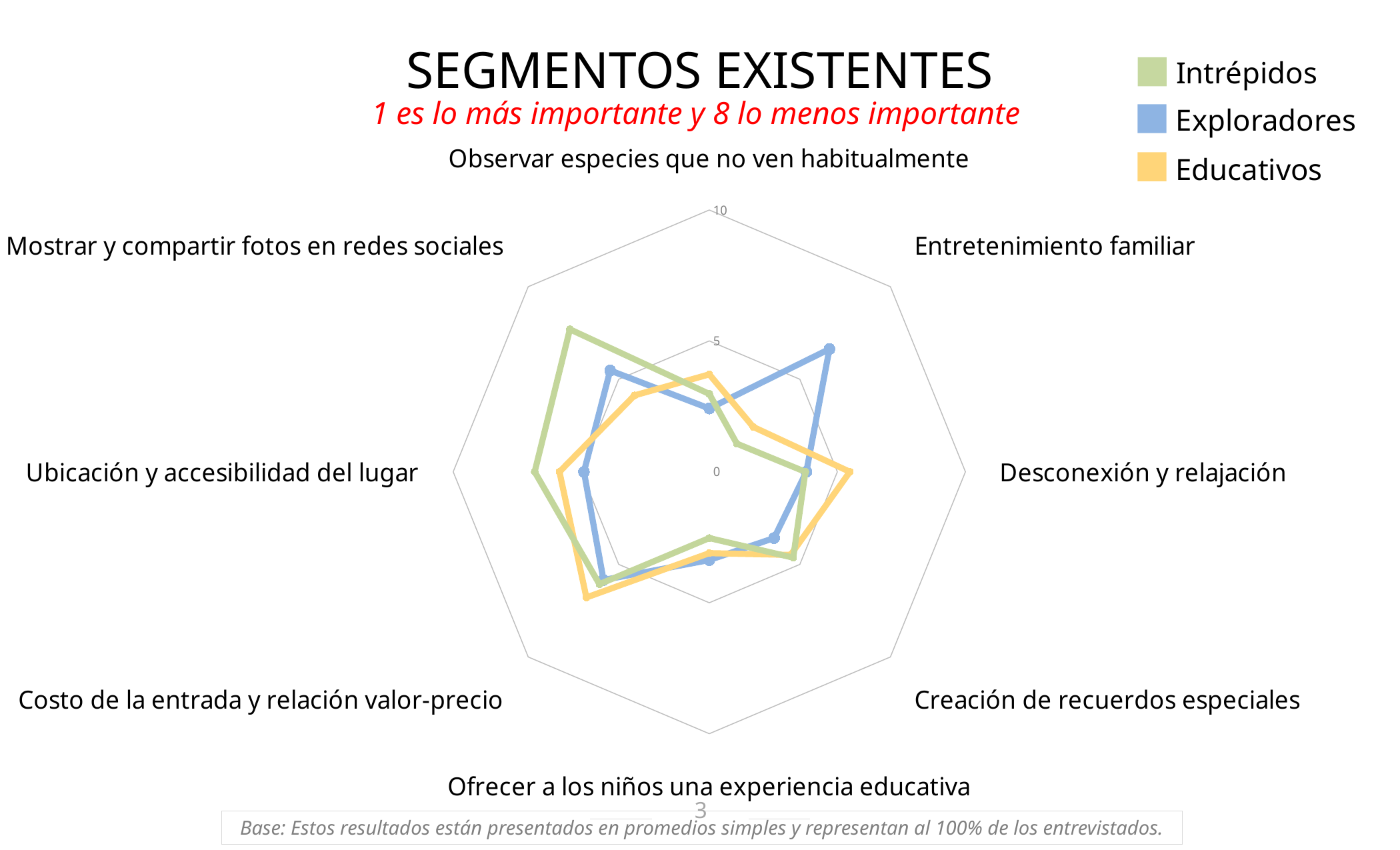
Is the value for Exploradores on Entretenimiento familiar greater or less than 5? greater What is the title of the chart? SEGMENTOS EXISTENTES How many series does the legend list? 3 Is the value for Intrépidos on Observar especies que no ven habitualmente greater or less than 5? less Is the value for Educativos on Costo de la entrada y relación valor-precio greater or less than 5? greater For the Intrépidos series, which category has the lowest value? Entretenimiento familiar Which series is shown in blue in the legend? Exploradores What kind of chart is shown on the slide? Radar chart On Mostrar y compartir fotos en redes sociales, which series has the larger value, Intrépidos or Educativos? Intrépidos How many categories (axes) does the radar chart have? 8